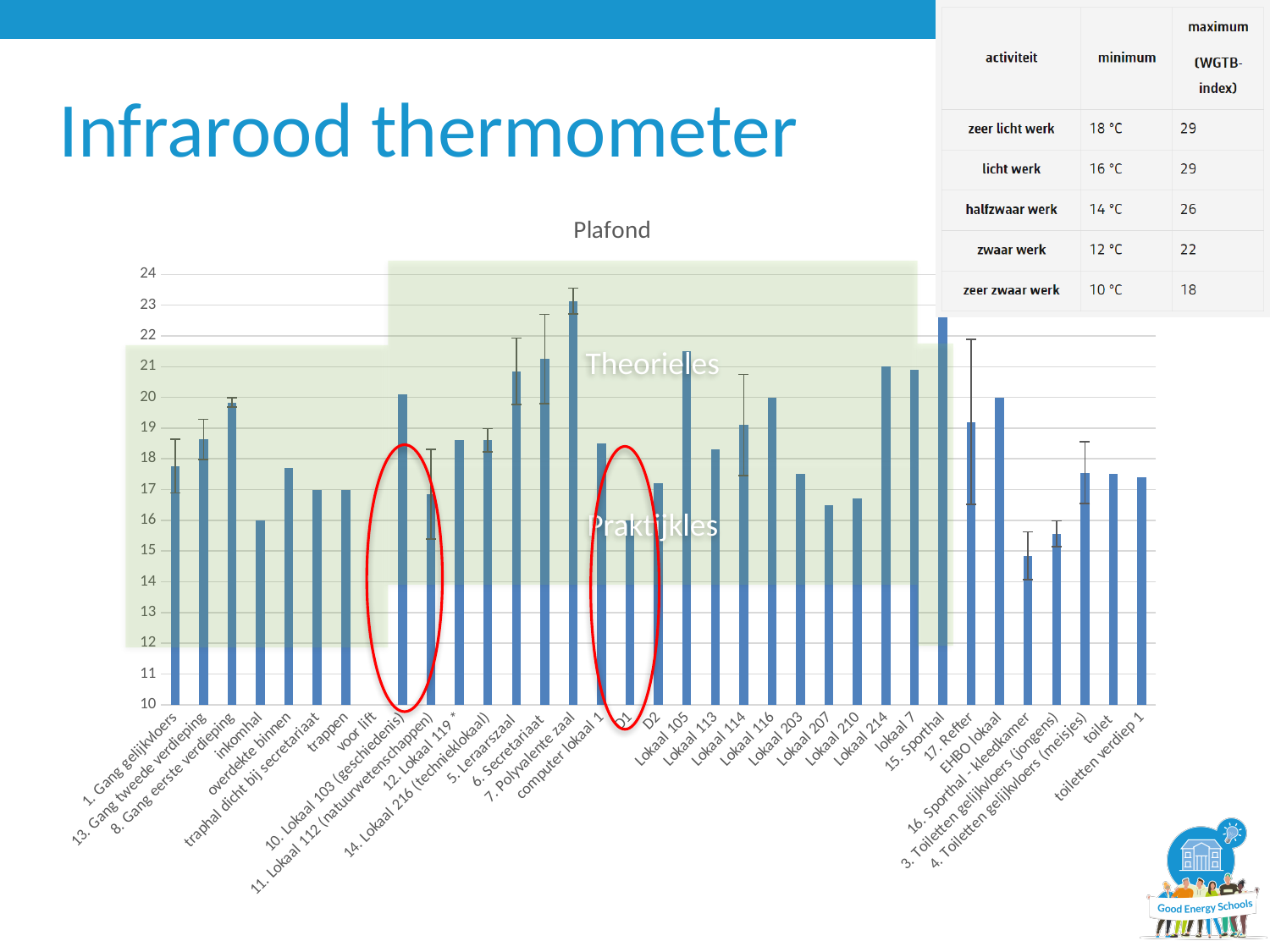
Is the value for 7. Polyvalente zaal greater or less than 22? greater Is the value for inkomhal greater or less than 17? less Is the value for 15. Sporthal greater or less than 21? greater What are the two labelled regions overlaid on the chart? Theorieles and Praktijkles What is the title of the chart? Plafond What kind of chart is shown on the slide? bar chart Which category has the lowest bar in the chart? 16. Sporthal - kleedkamer Which is larger, the value for 1. Gang gelijkvloers or for 13. Gang tweede verdieping? 13. Gang tweede verdieping Which is larger, the value for Lokaal 207 or for Lokaal 105? Lokaal 105